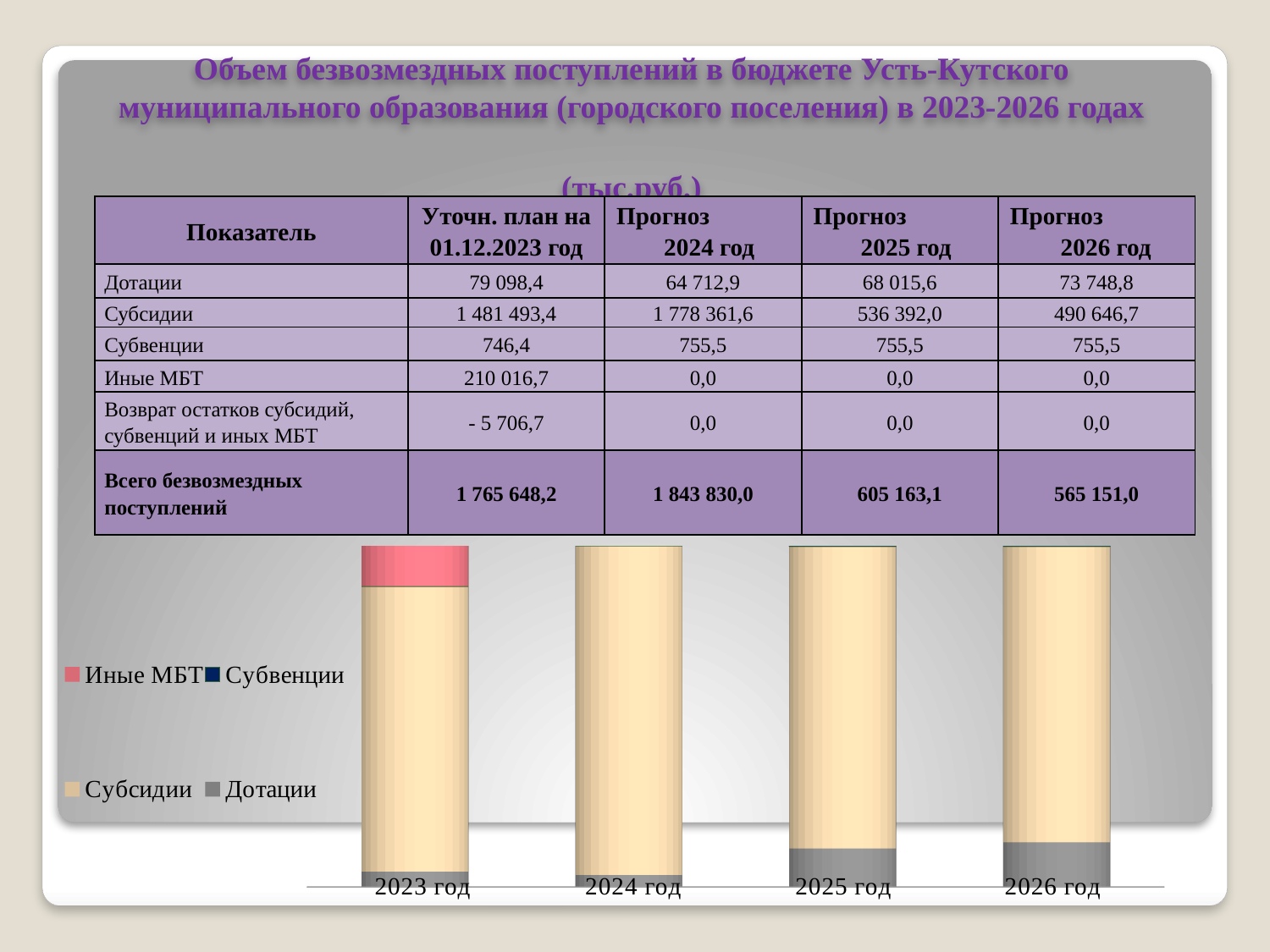
How many series does the chart legend list? 4 Which year's bar has the smallest Дотации segment? 2024 год Is the Дотации segment larger in the 2025 год bar or the 2024 год bar? 2025 год What kind of chart is shown at the bottom of the slide? stacked bar chart Which series is shown at the bottom of each stacked bar? Дотации From 2024 год to 2026 год, does the Дотации segment in the bars grow or shrink? grow How many bars (years) are plotted in the chart? 4 Which year's bar has the largest Дотации segment? 2026 год Which year's bar is the only one with a visible Иные МБТ (pink) segment? 2023 год Which series are listed in the chart legend? Иные МБТ, Субвенции, Субсидии, Дотации Which series occupies the largest part of every bar in the chart? Субсидии